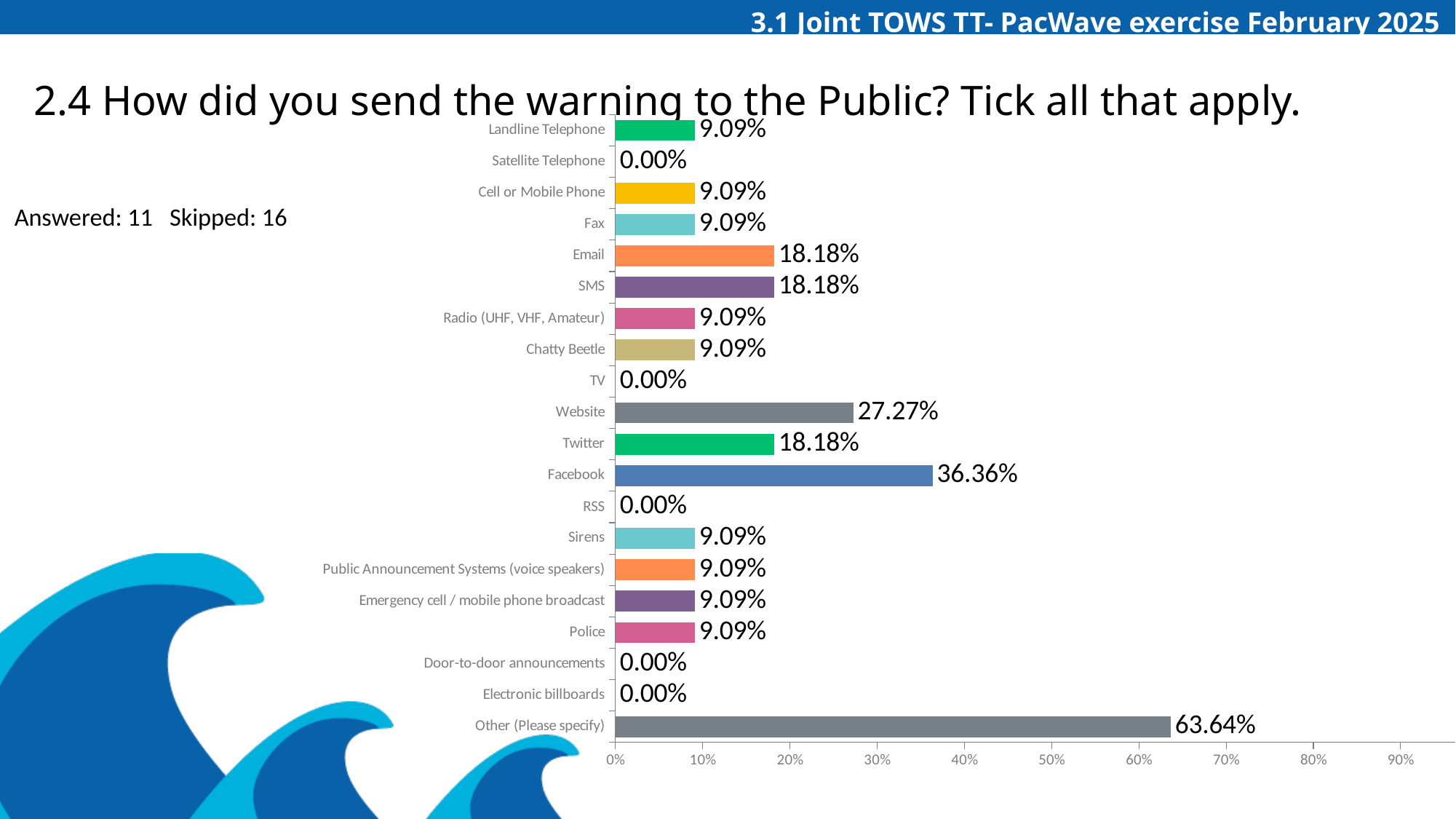
What is the difference between the values for Other (Please specify) and Facebook? 27.28% What kind of chart is shown on the slide? bar chart What is the value for Email? 18.18% What is the difference between the values for Facebook and Website? 9.09% What is the value for Website? 27.27% Which is larger, the value for Twitter or the value for Website? Website What is the value for Other (Please specify)? 63.64% How many categories are shown in the chart? 20 Which category has the highest value? Other (Please specify) Is the value for Other (Please specify) greater or less than 60%? greater What is the value for TV? 0.00% What is the value for Facebook? 36.36%